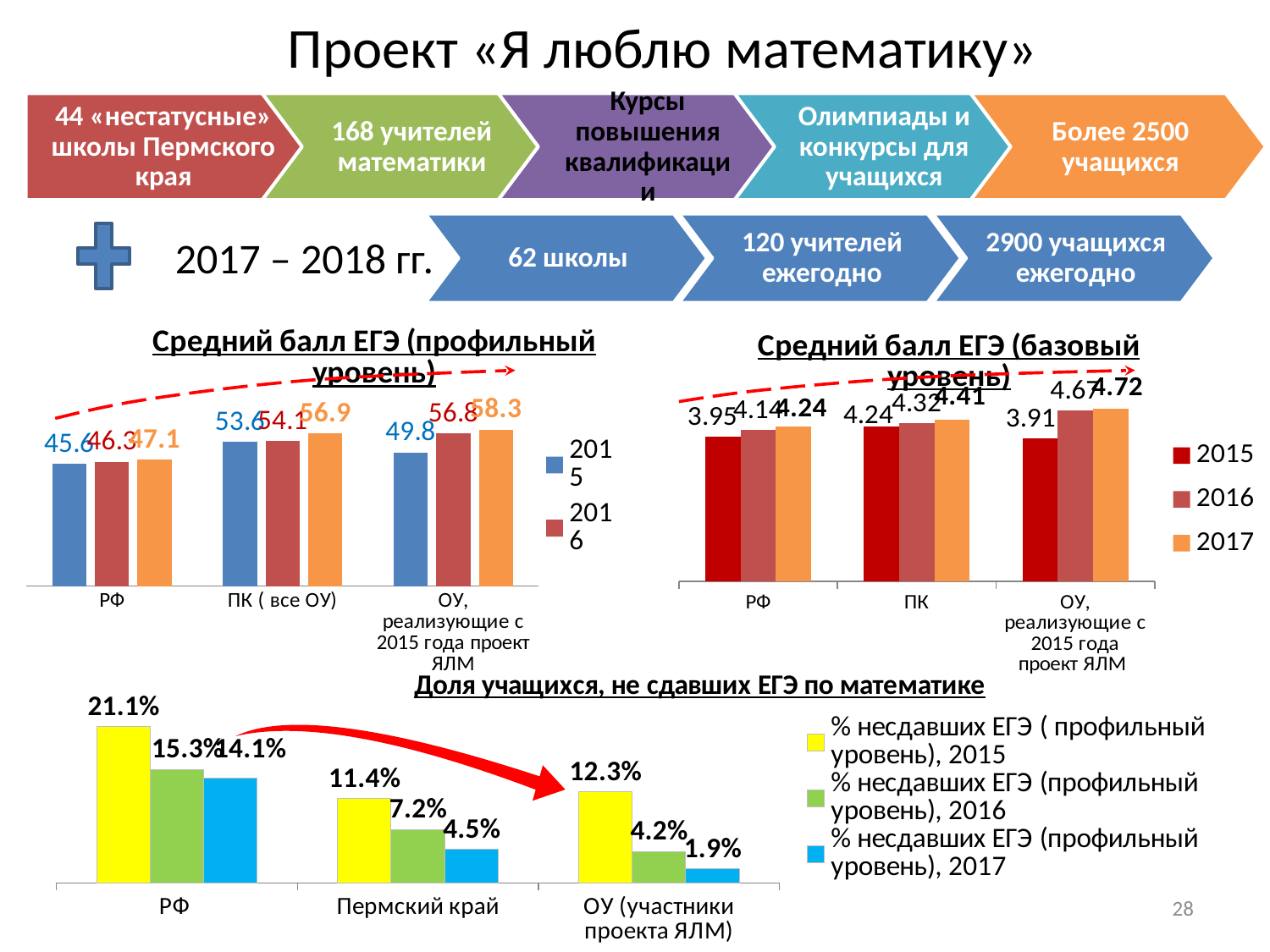
In the chart 'Средний балл ЕГЭ (базовый уровень)', which is larger: the 2017 value for РФ or the 2017 value for ПК? ПК In the chart 'Средний балл ЕГЭ (базовый уровень)', what is the value for ОУ, реализующие с 2015 года проект ЯЛМ in 2016? 4.67 In the chart 'Средний балл ЕГЭ (базовый уровень)', how many series does the legend list? 3 What type of chart is 'Доля учащихся, не сдавших ЕГЭ по математике'? Bar chart In the chart 'Доля учащихся, не сдавших ЕГЭ по математике', what is the difference between the 2015 and 2017 values for Пермский край? 6.9% In the chart 'Средний балл ЕГЭ (профильный уровень)', what is the difference between the 2017 and 2015 values for ОУ, реализующие с 2015 года проект ЯЛМ? 8.5 In the chart 'Средний балл ЕГЭ (базовый уровень)', which category has the lowest 2015 value? ОУ, реализующие с 2015 года проект ЯЛМ In the chart 'Средний балл ЕГЭ (профильный уровень)', what is the value for РФ in 2015? 45.6 In the chart 'Доля учащихся, не сдавших ЕГЭ по математике', what is the 2017 value for ОУ (участники проекта ЯЛМ)? 1.9% In the chart 'Доля учащихся, не сдавших ЕГЭ по математике', which category has the highest 2015 value? РФ In the chart 'Средний балл ЕГЭ (профильный уровень)', what is the value for ПК (все ОУ) in 2017? 56.9 In the chart 'Средний балл ЕГЭ (профильный уровень)', how many categories are shown on the x axis? 3